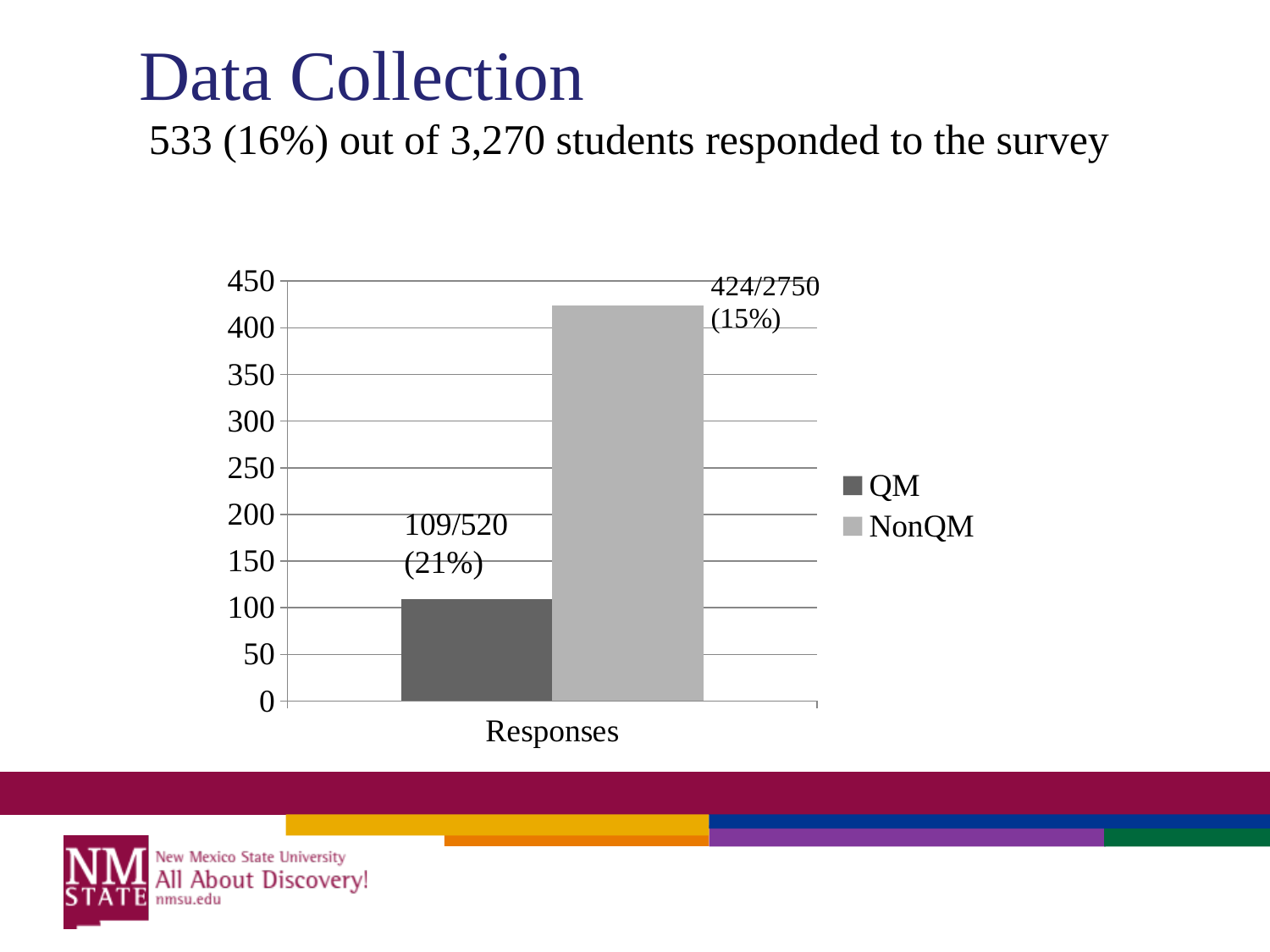
What kind of chart is shown on the slide? bar chart Which series has the taller bar, QM or NonQM? NonQM What response rate percentage is shown for NonQM? 15% What is the difference in the number of responses between NonQM and QM? 315 How many series does the legend list? 2 What is the category label on the x axis? Responses What is the data label shown on the NonQM bar? 424/2750 (15%) What response rate percentage is shown for QM? 21% What is the data label shown on the QM bar? 109/520 (21%) How many responses does the QM bar represent? 109 What are the two series named in the legend? QM and NonQM How many responses does the NonQM bar represent? 424